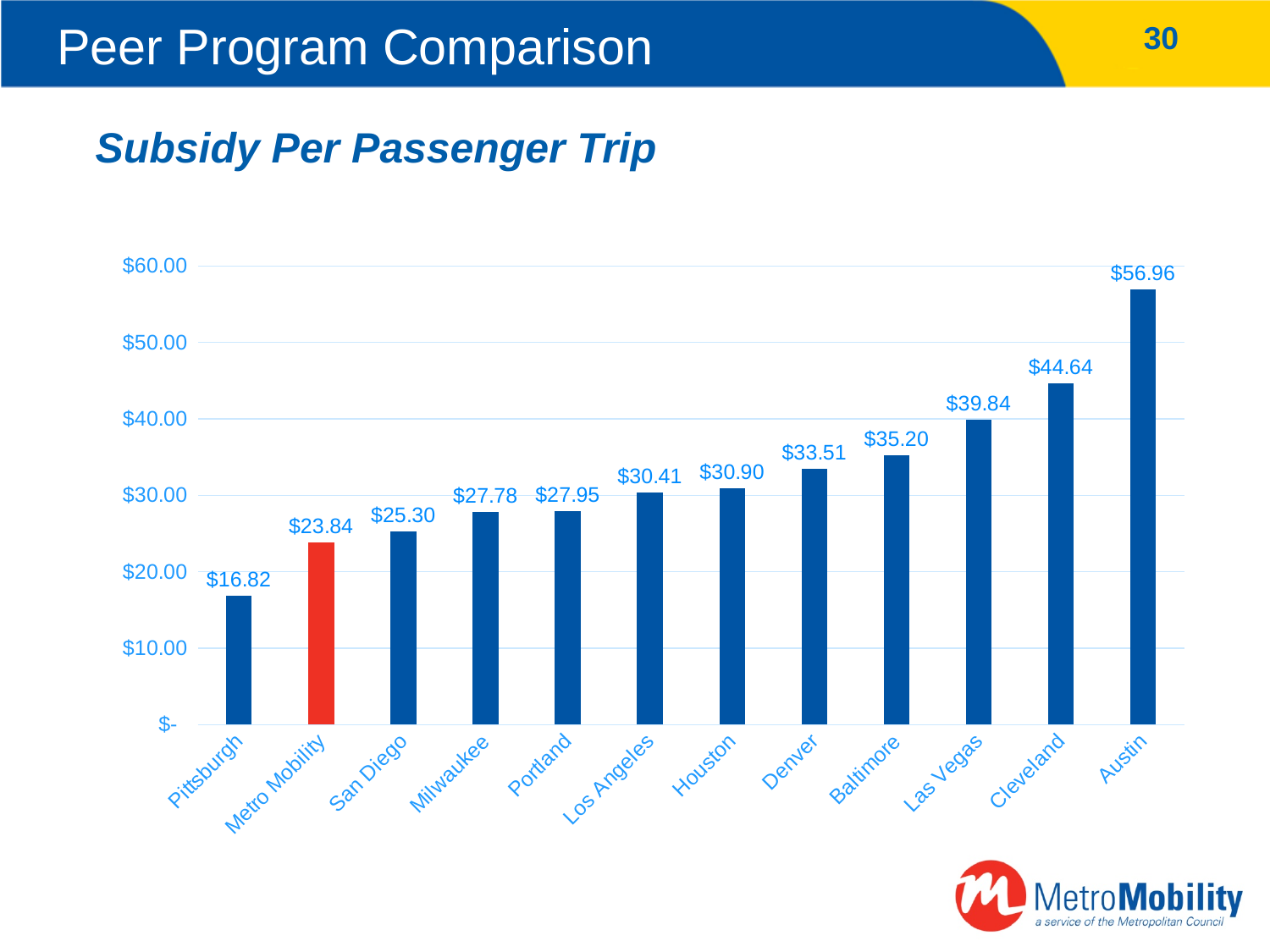
What is the subsidy per passenger trip for Metro Mobility? $23.84 Which city has the lowest subsidy per passenger trip? Pittsburgh What is the difference between the subsidy per passenger trip for San Diego and Metro Mobility? $1.46 What is the difference between the subsidy per passenger trip for Austin and Pittsburgh? $40.14 Which has a higher subsidy per passenger trip, Las Vegas or Baltimore? Las Vegas What is the subsidy per passenger trip for Cleveland? $44.64 How many cities or programs are shown in the chart? 12 Which city has the highest subsidy per passenger trip? Austin What type of chart is shown on the slide? Bar chart Which bar in the chart is coloured red rather than blue? Metro Mobility Is the subsidy per passenger trip for Denver greater or less than $30.00? greater What is the subsidy per passenger trip for Houston? $30.90